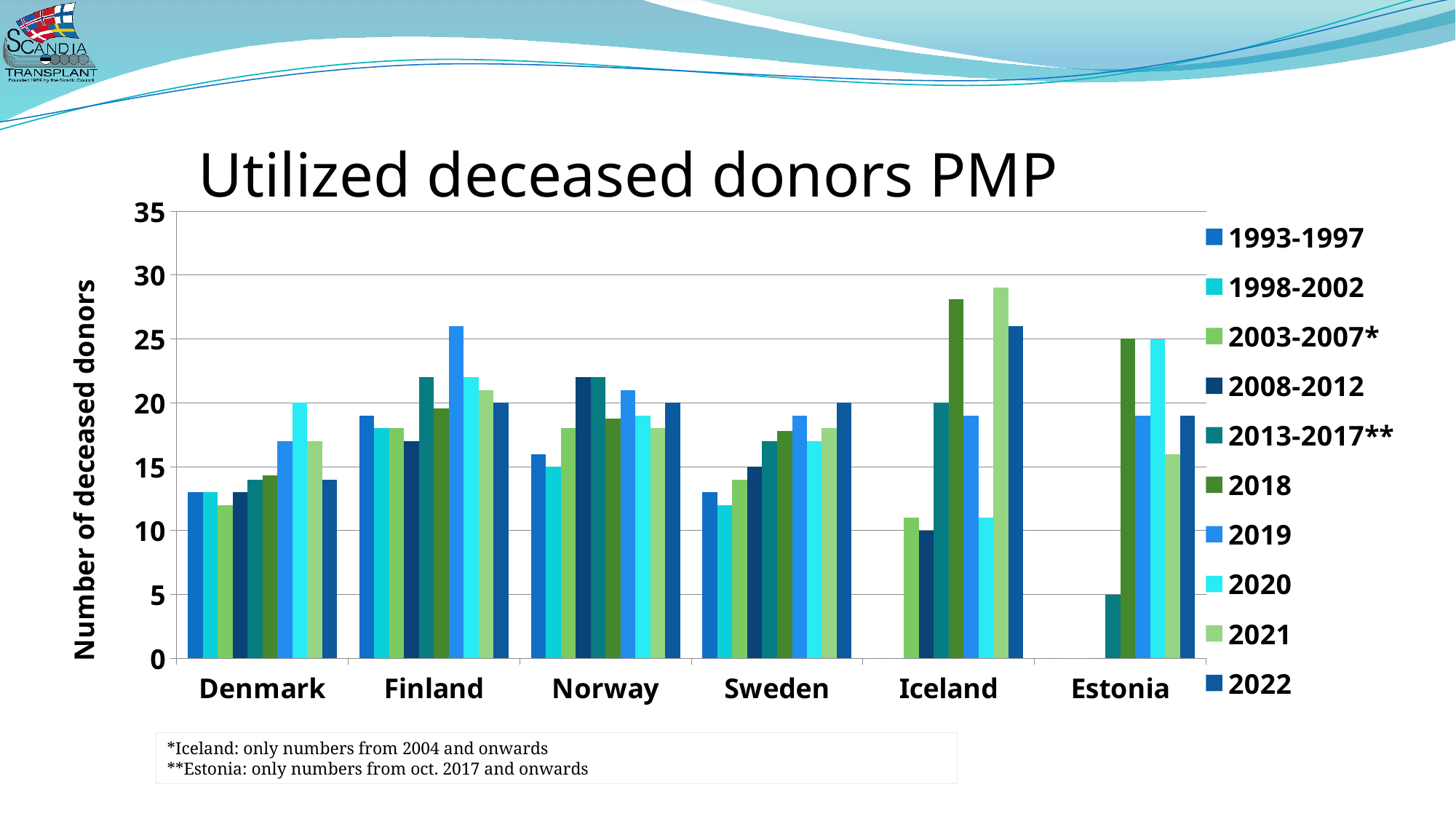
For Denmark, which is larger: the value for 2020 or the value for 2022? 2020 What is the title of the y axis? Number of deceased donors Is the value for Estonia in 2013-2017** greater or less than 10? less Is the value for Finland in 2019 greater or less than 25? greater How many countries are shown on the x axis? 6 What kind of chart is shown on the slide? Bar chart Is the value for Sweden in 1998-2002 greater or less than 15? less Which country has the highest value for 2020? Estonia How many series does the legend list? 10 For Iceland, which is larger: the value for 2018 or the value for 2019? 2018 Which country has the lowest value for 2013-2017**? Estonia